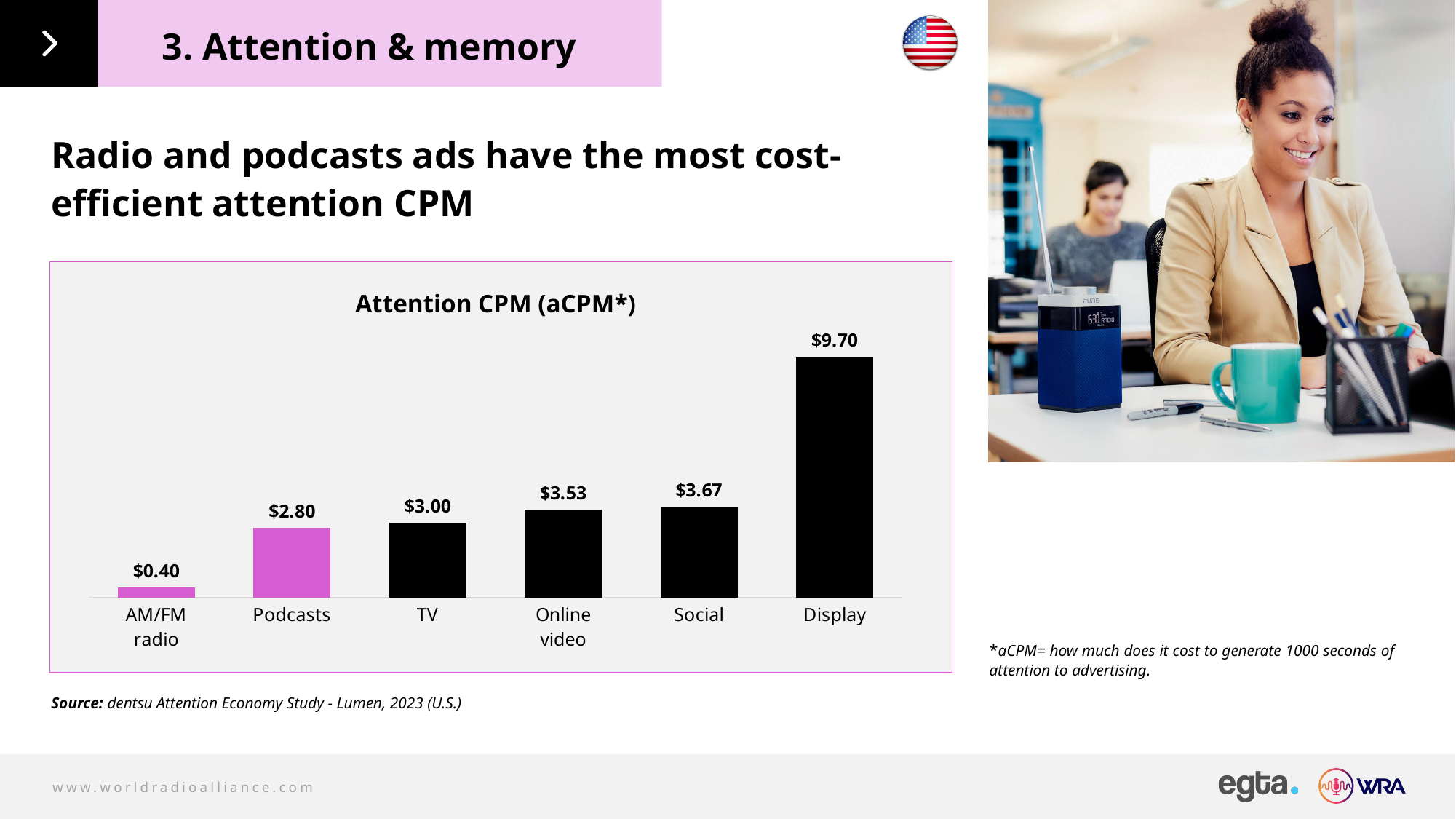
What is the title of the chart? Attention CPM (aCPM*) What is the Attention CPM value for Podcasts? $2.80 What is the difference between the Attention CPM for Display and for TV? $6.70 Which category has the lowest Attention CPM? AM/FM radio What type of chart is used to show Attention CPM? Bar chart What is the Attention CPM value for Social? $3.67 How many categories are shown in the Attention CPM chart? 6 Which category has the highest Attention CPM? Display What is the difference between the Attention CPM for Podcasts and for AM/FM radio? $2.40 Which has a higher Attention CPM, TV or Social? Social What is the Attention CPM value for AM/FM radio? $0.40 What is the Attention CPM value for Online video? $3.53